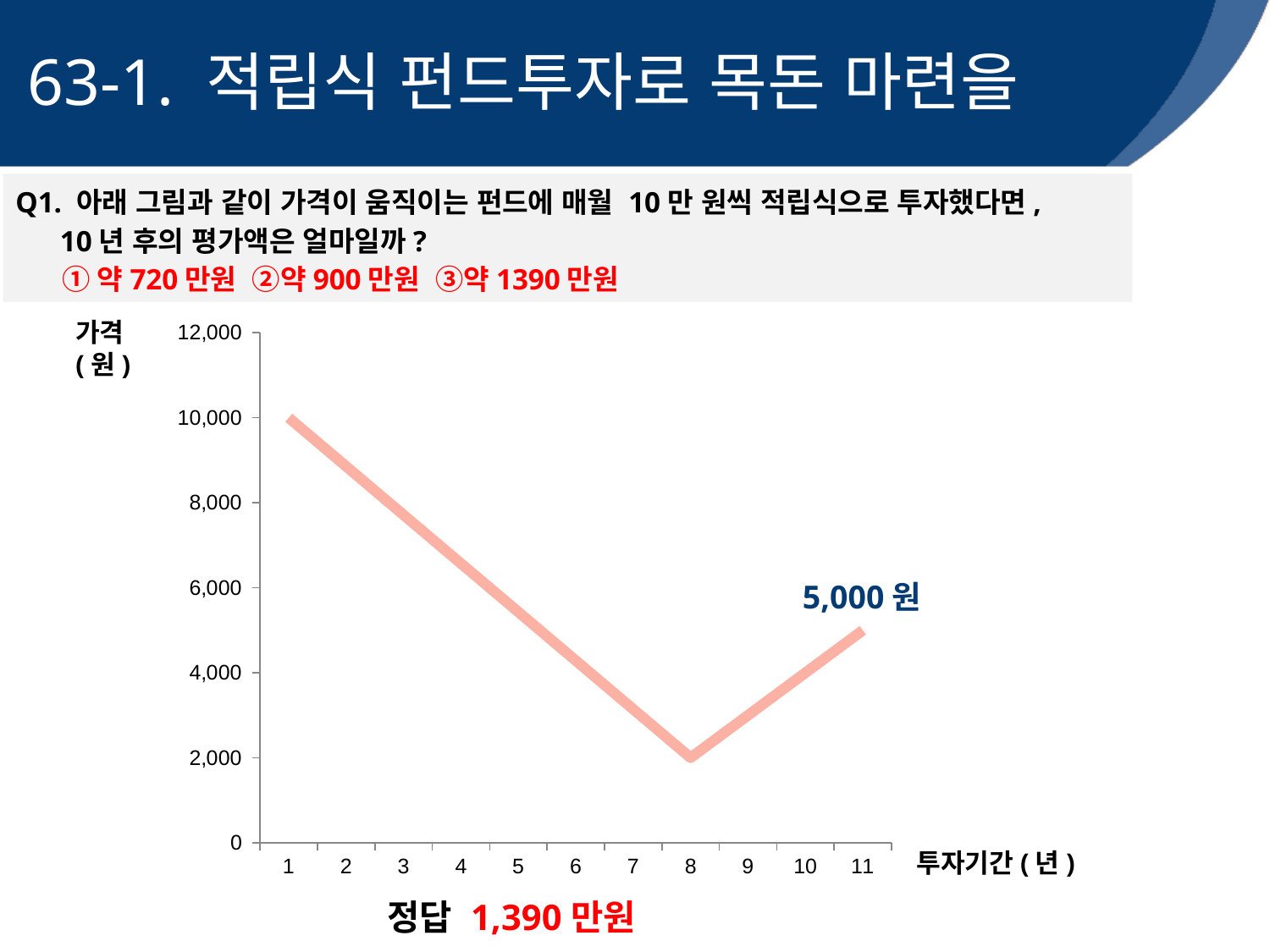
Is the price at year 10 greater or less than 2,000? greater Which is larger, the price at year 1 or the price at year 11? year 1 At which investment year is the price lowest? 8 What is the price (원) at investment year 11, as printed on the chart? 5,000 원 What is the price at investment year 1? 10,000 What is the price at investment year 8? 2,000 What is the label of the x axis? 투자기간 ( 년 ) How many investment years are marked on the x axis? 11 Is the price at year 5 greater or less than 8,000? less What kind of chart is shown on the slide? line chart At which investment year is the price highest? 1 Does the price rise or fall from year 1 to year 8? fall